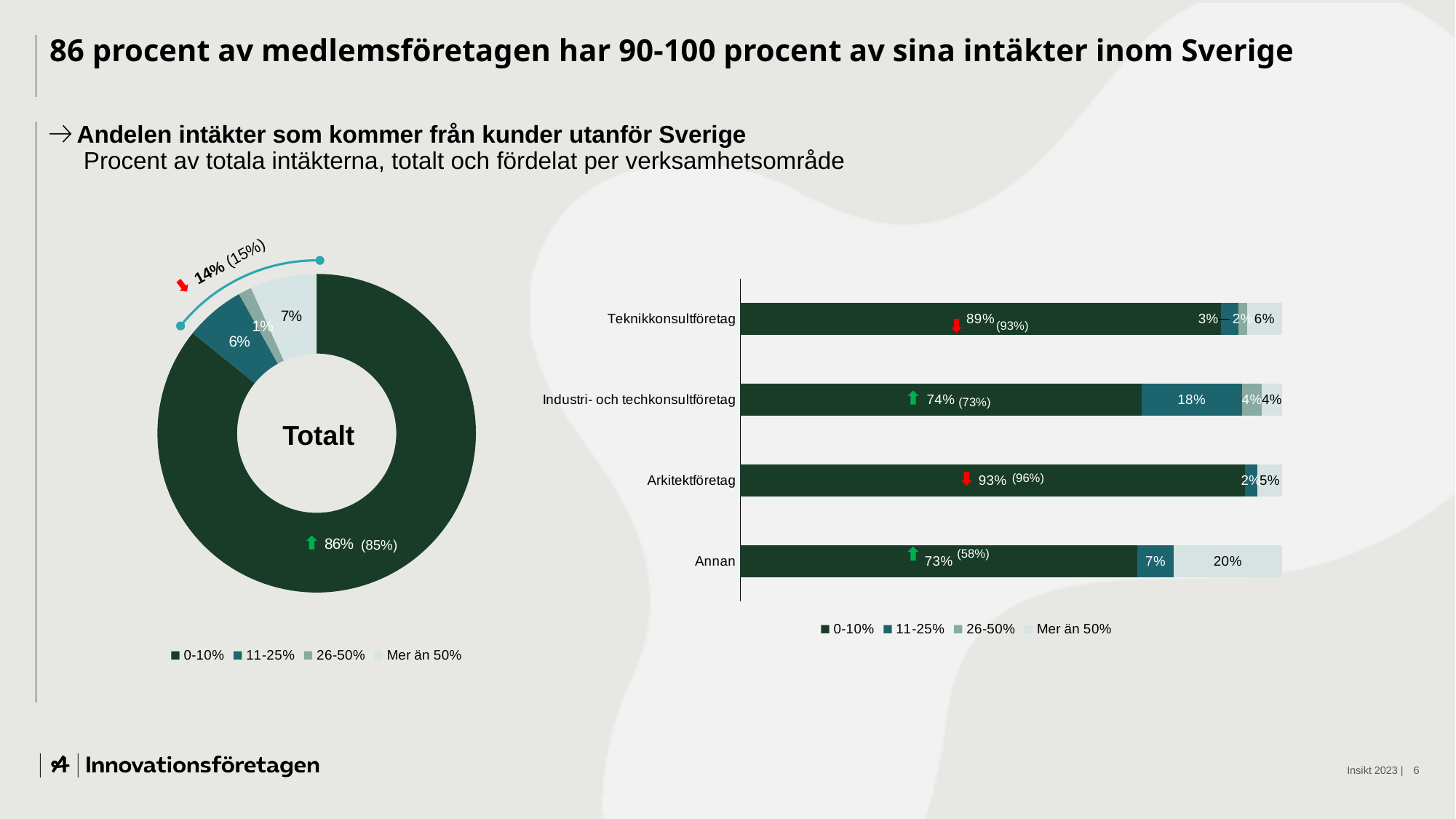
In the bar chart on the right, what is the difference between the 0-10% values for Teknikkonsultföretag and Annan? 16 percentage points In the bar chart on the right, what is the 'Mer än 50%' value for Annan? 20% In the bar chart on the right, which category has the highest 0-10% value? Arkitektföretag In the donut chart on the left, which category has the smallest slice? 26-50% In the bar chart on the right, what is the 0-10% value for Arkitektföretag? 93% In the bar chart on the right, what is the 11-25% value for Industri- och techkonsultföretag? 18% In the donut chart on the left, what is the value for the 'Mer än 50%' slice? 7% In the donut chart on the left, what is the difference between the 'Mer än 50%' slice and the '11-25%' slice? 1 percentage point What kind of chart is the chart on the right? Stacked bar chart In the donut chart on the left, what share of companies have 0-10% of revenue from customers outside Sweden? 86% In the bar chart on the right, how many series does the legend list? 4 In the bar chart on the right, how many categories are shown on the vertical axis? 4